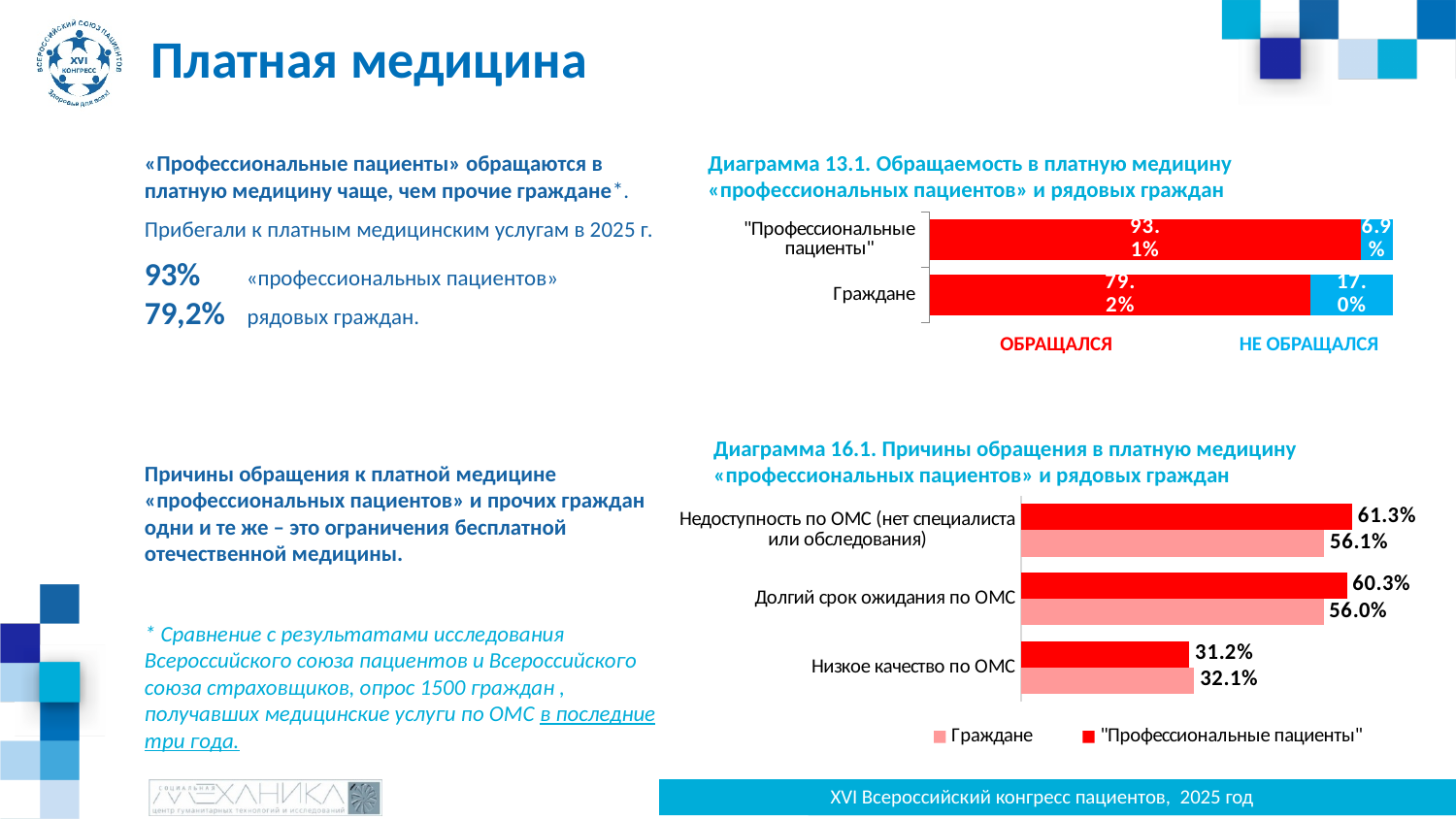
На диаграмме 13.1 какая доля граждан не обращалась в платную медицину? 17.0% На диаграмме 16.1 какое значение у граждан по причине «Низкое качество по ОМС»? 32.1% На диаграмме 16.1 какое значение у «профессиональных пациентов» по причине «Долгий срок ожидания по ОМС»? 60.3% На диаграмме 16.1 на сколько процентных пунктов значение «профессиональных пациентов» по причине «Недоступность по ОМС» больше значения граждан? 5.2 На диаграмме 13.1 какая доля граждан обращалась в платную медицину? 79.2% На диаграмме 13.1 какая доля «профессиональных пациентов» обращалась в платную медицину? 93.1% На диаграмме 13.1 у кого доля обращавшихся выше: у «профессиональных пациентов» или у граждан? «Профессиональные пациенты» Какого типа диаграмма 13.1? Столбчатая (bar chart) с накоплением На диаграмме 16.1 какая причина имеет наименьшее значение среди граждан? Низкое качество по ОМС Сколько категорий (причин) показано на диаграмме 16.1? 3 На диаграмме 16.1 какая причина имеет наибольшее значение среди «профессиональных пациентов»? Недоступность по ОМС (нет специалиста или обследования) На диаграмме 13.1 сколько серий указано в легенде? 2